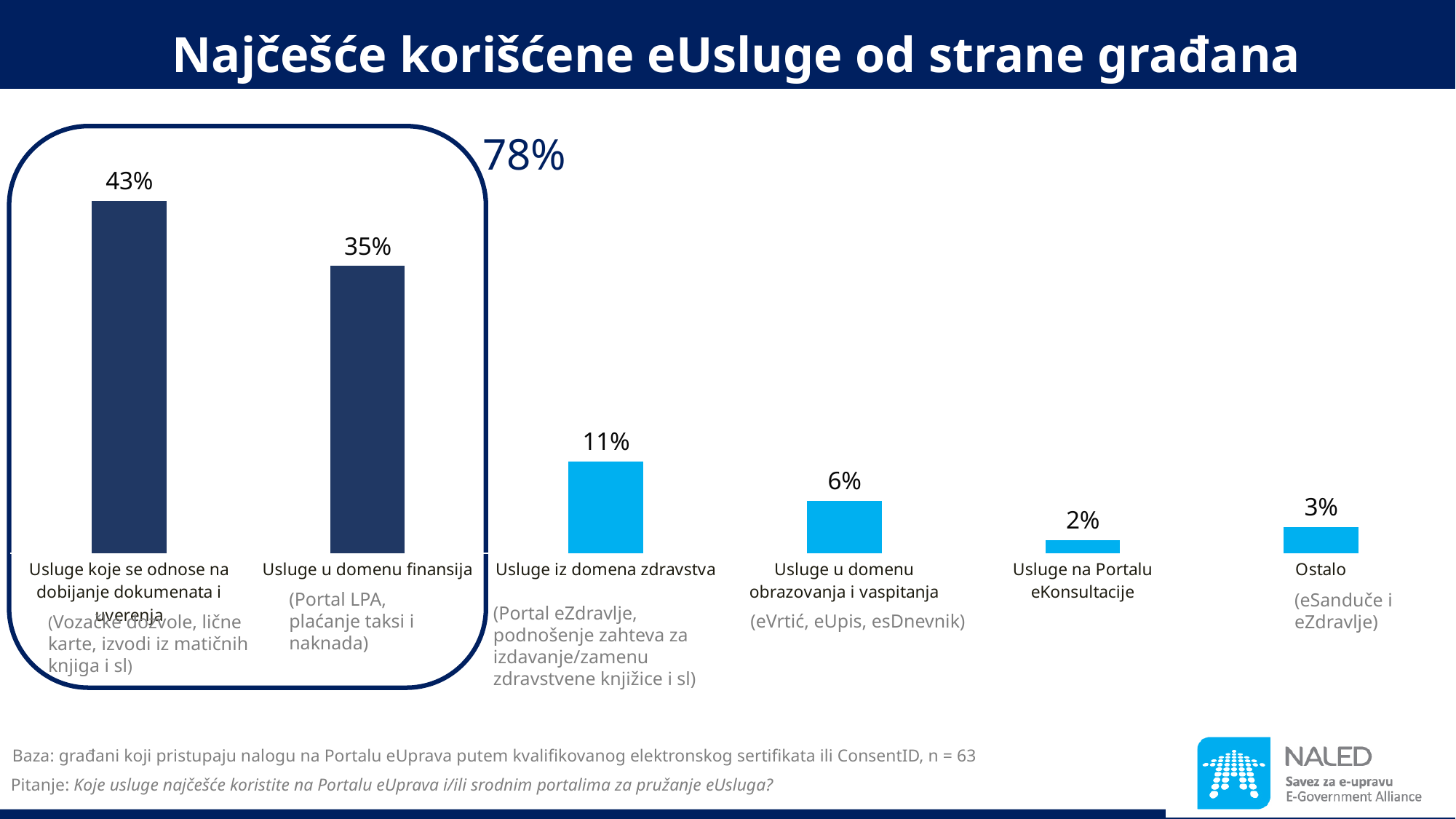
What is the value for 'Usluge u domenu finansija'? 35% What is the difference between the values for 'Usluge koje se odnose na dobijanje dokumenata i uverenja' and 'Usluge u domenu finansija'? 8% What is the value for 'Ostalo'? 3% What is the value for 'Usluge na Portalu eKonsultacije'? 2% How many categories are shown in the chart? 6 What kind of chart is shown on the slide? Bar chart Which category has the lowest value? Usluge na Portalu eKonsultacije Which is larger: the value for 'Usluge u domenu obrazovanja i vaspitanja' or the value for 'Ostalo'? Usluge u domenu obrazovanja i vaspitanja Which category has the highest value? Usluge koje se odnose na dobijanje dokumenata i uverenja What is the title of the slide? Najčešće korišćene eUsluge od strane građana What is the value for 'Usluge koje se odnose na dobijanje dokumenata i uverenja'? 43% What is the value for 'Usluge iz domena zdravstva'? 11%